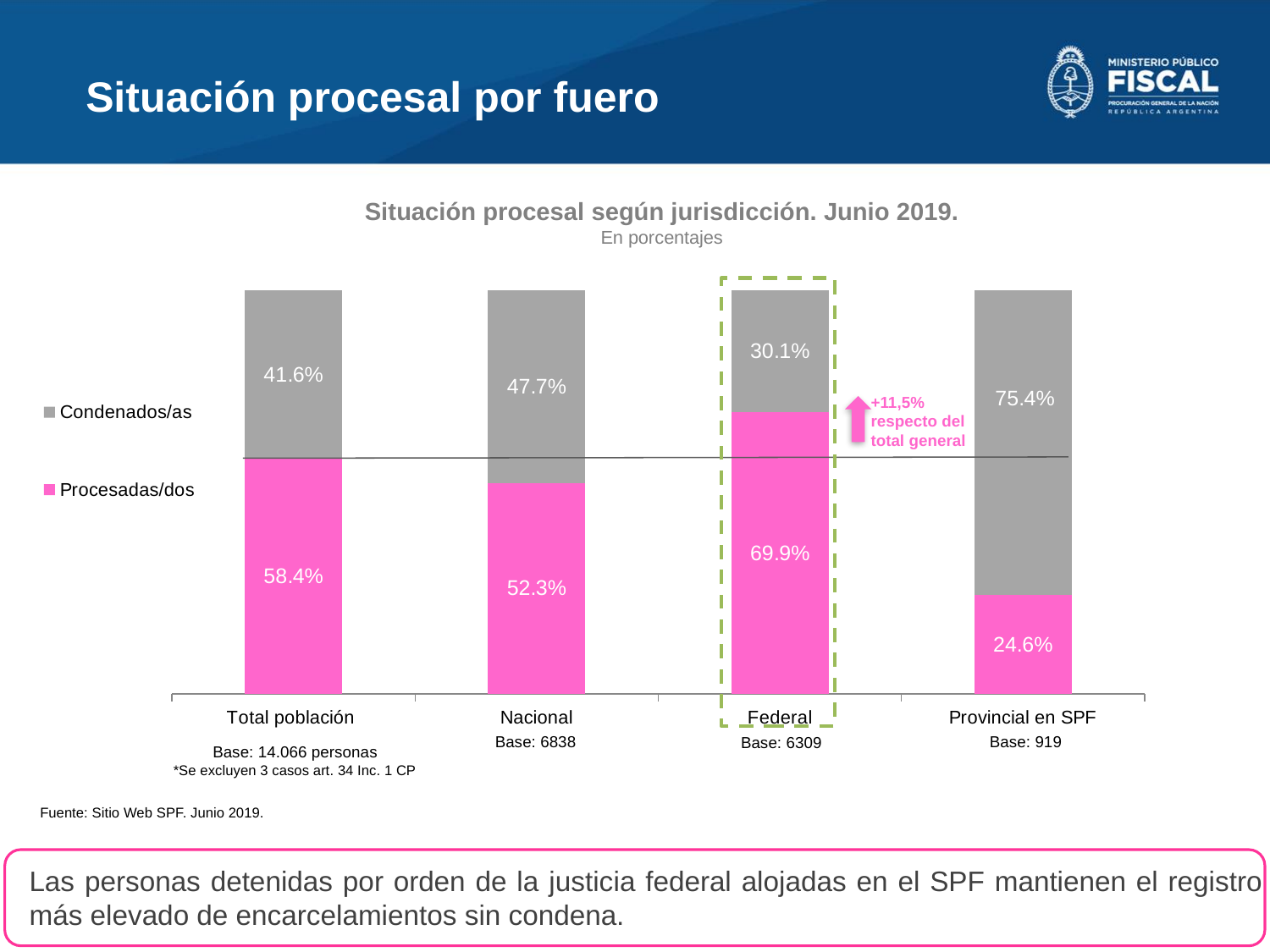
What is the base (number of persons) shown for the Federal category? 6309 How many series does the legend list? 2 How many categories are shown on the x axis? 4 What is the difference between the Procesadas/dos values for Federal and Total población? 11.5% What is the value for Procesadas/dos in the Federal category? 69.9% Which category has the lowest value for Condenados/as? Federal Which is larger: Condenados/as for Nacional or Condenados/as for Total población? Nacional What is the value for Condenados/as in the Total población category? 41.6% What kind of chart is shown on the slide? Stacked bar chart What is the value for Condenados/as in the Provincial en SPF category? 75.4% What is the value for Procesadas/dos in the Nacional category? 52.3% Which category has the highest value for Procesadas/dos? Federal